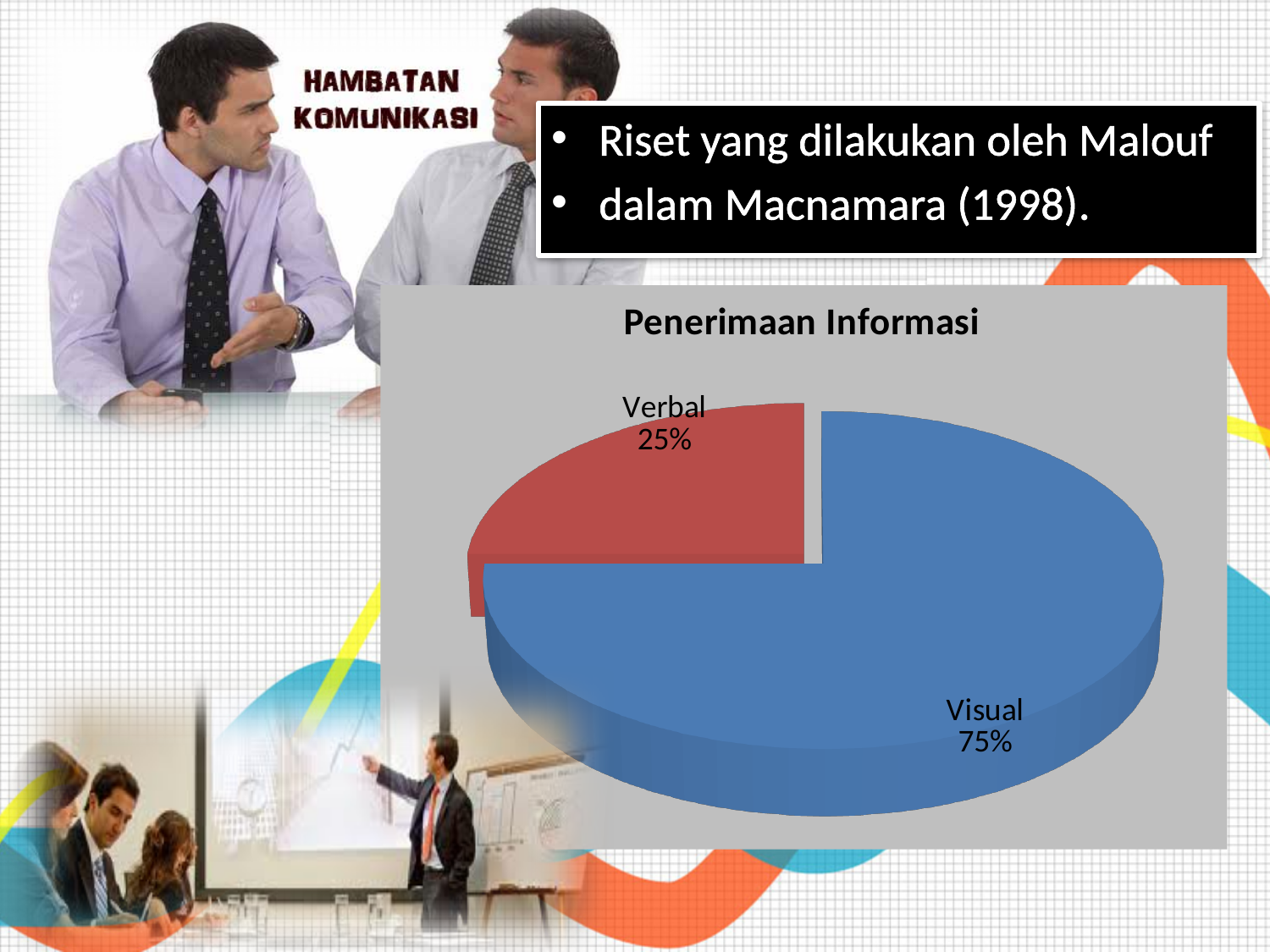
What share of the pie does the Verbal slice represent? 25% What is the value for Verbal in the pie chart? 25% What is the difference between the Visual and Verbal shares? 50% How many categories are shown in the pie chart? 2 Which is larger, the share for Visual or the share for Verbal? Visual What colour is the Visual slice of the pie chart? Blue What is the title of the chart? Penerimaan Informasi Which category has the largest share of the pie chart? Visual What is the value for Visual in the pie chart? 75% Which category has the smallest share of the pie chart? Verbal What kind of chart is shown on the slide? Pie chart